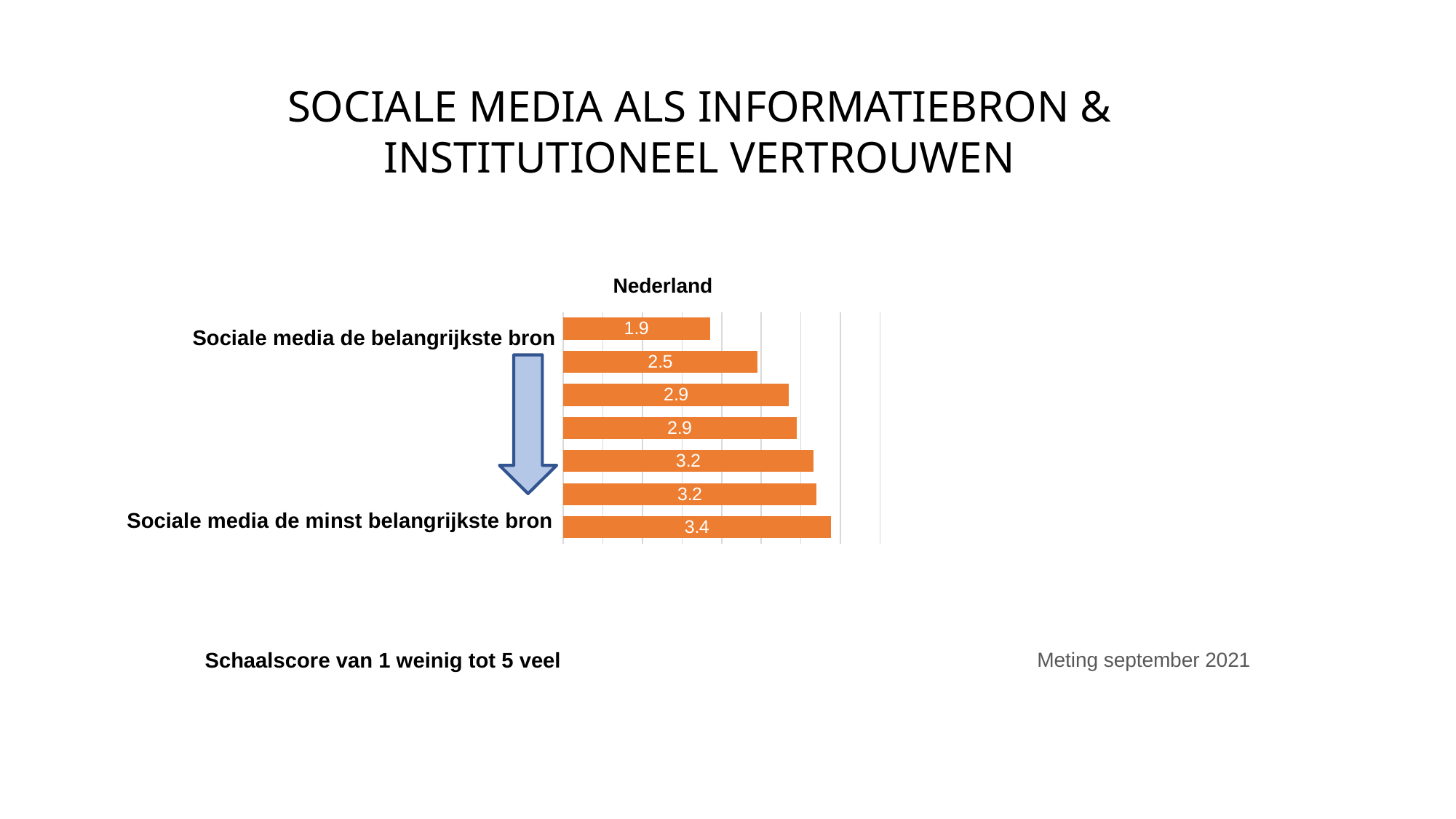
What is the highest value shown in the Nederland chart? 3.4 Which labelled category has the highest value in the Nederland chart? Sociale media de minst belangrijkste bron What kind of chart is shown on the slide? Bar chart What is the difference between the values for 'Sociale media de minst belangrijkste bron' and 'Sociale media de belangrijkste bron'? 1.5 How many bars are shown in the Nederland chart? 7 What is the value of the bar labelled 'Sociale media de minst belangrijkste bron' in the Nederland chart? 3.4 Do the bar values increase or decrease going from the top bar to the bottom bar in the Nederland chart? Increase What is the value of the bar labelled 'Sociale media de belangrijkste bron' in the Nederland chart? 1.9 What is the title of the chart on the slide? Nederland What is the value of the second bar from the top in the Nederland chart? 2.5 Which labelled category has the lowest value in the Nederland chart? Sociale media de belangrijkste bron Which is larger: the value for 'Sociale media de belangrijkste bron' or for 'Sociale media de minst belangrijkste bron'? Sociale media de minst belangrijkste bron